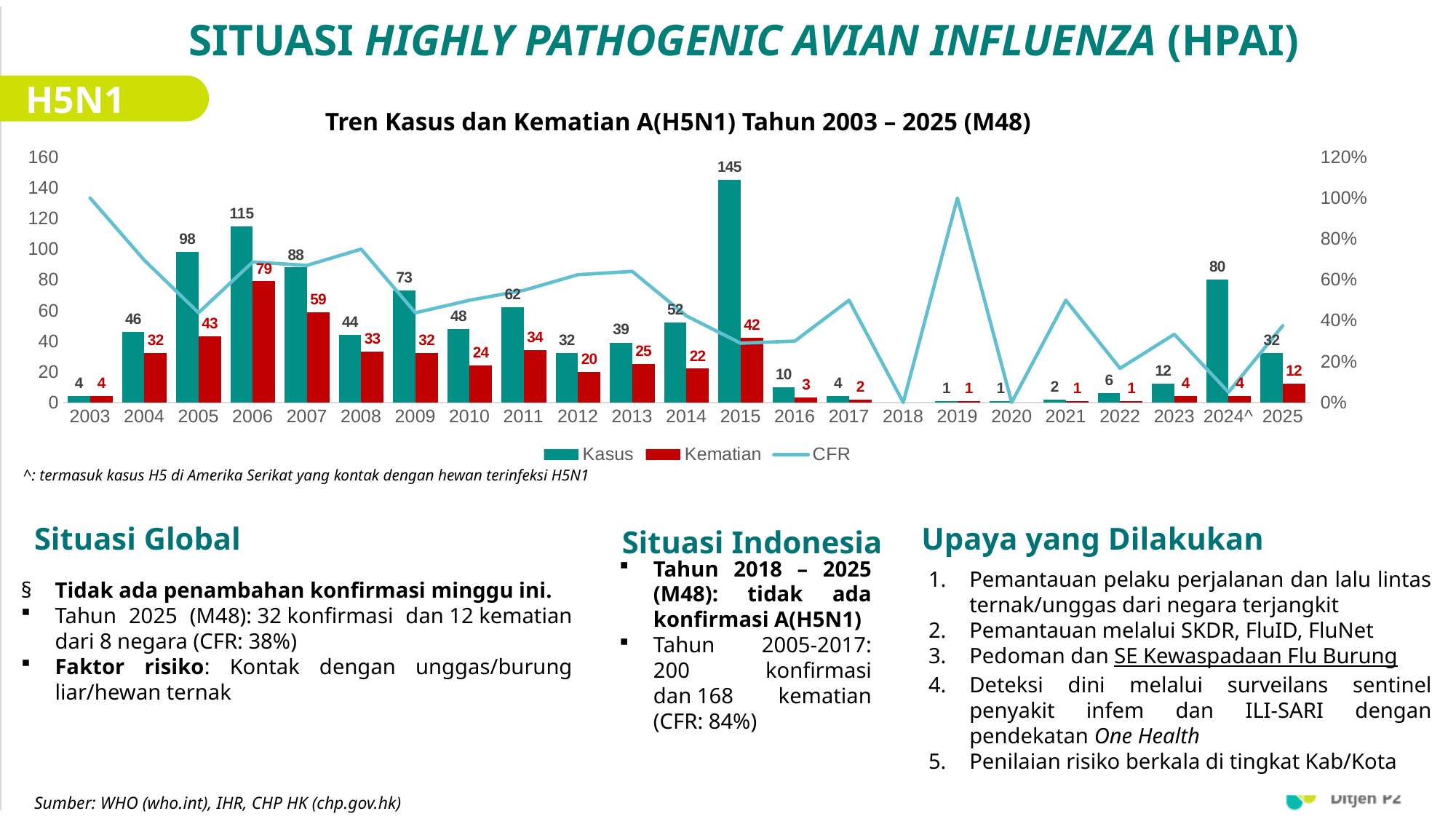
Which year has the highest Kematian value? 2006 What is the value of Kematian for 2006? 79 How many years are shown on the x axis? 23 Which is larger, Kasus in 2006 or Kasus in 2005? Kasus in 2006 What is the value of Kasus for 2024^? 80 Which year has the highest Kasus value? 2015 What is the difference between Kasus and Kematian in 2025? 20 What is the value of Kasus for 2015? 145 What kind of chart is used to show Kasus and Kematian? Bar chart How many series does the legend list? 3 Is the CFR value for 2019 greater or less than 80%? greater What is the title of the chart? Tren Kasus dan Kematian A(H5N1) Tahun 2003 – 2025 (M48)